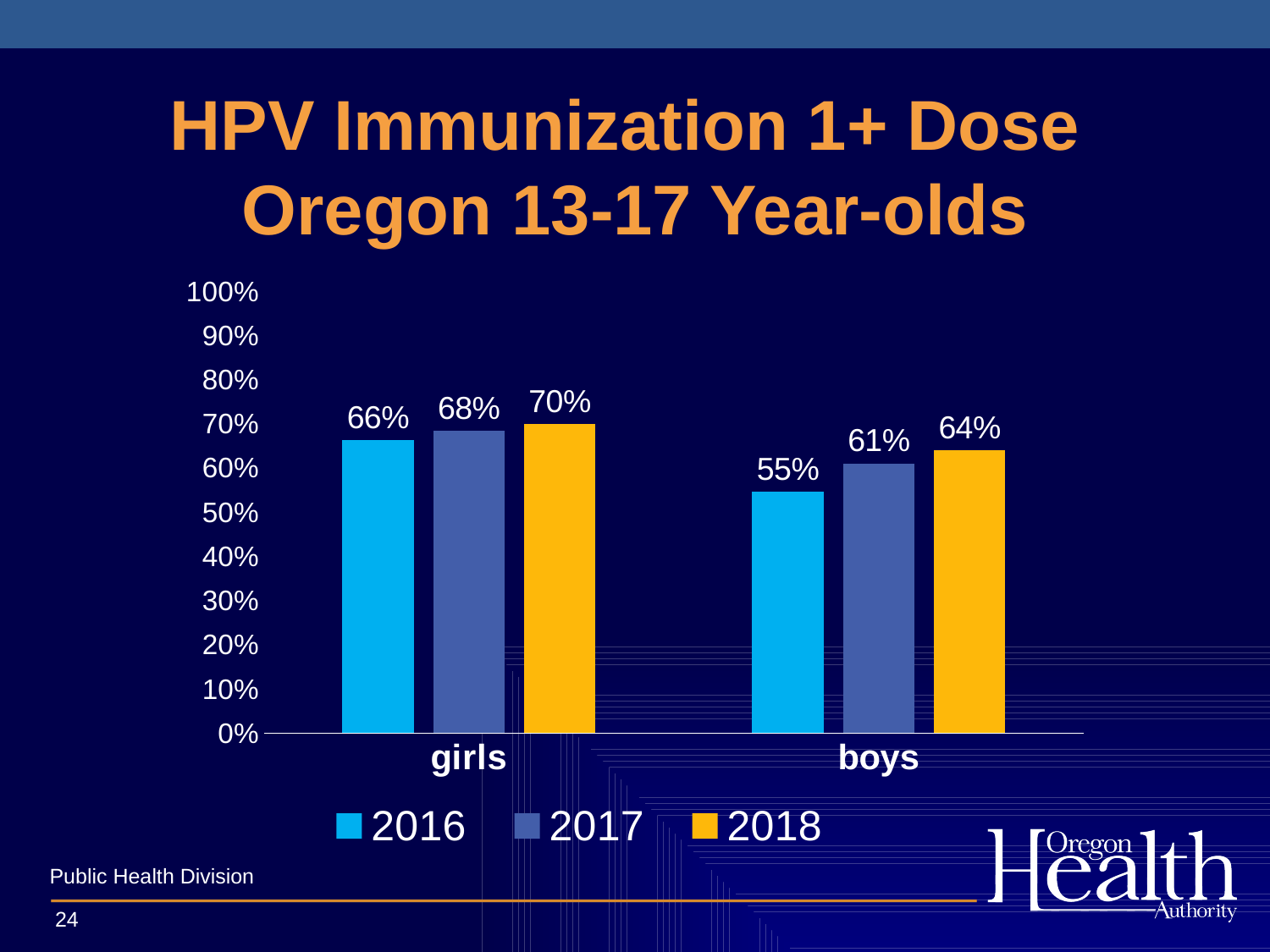
How many series does the legend list? 3 What is the value for boys in 2018? 64% Do the values for boys rise or fall from 2016 to 2018? rise Which year has the lowest value for girls? 2016 Is the value for boys in 2016 greater or less than 60%? less What is the value for girls in 2016? 66% What is the difference between the girls and boys values in 2016? 11% What kind of chart is shown on the slide? bar chart What is the difference between the 2018 and 2016 values for boys? 9% Which year has the highest value for boys? 2018 What is the value for boys in 2017? 61% Which is larger, the 2018 value for girls or the 2018 value for boys? girls